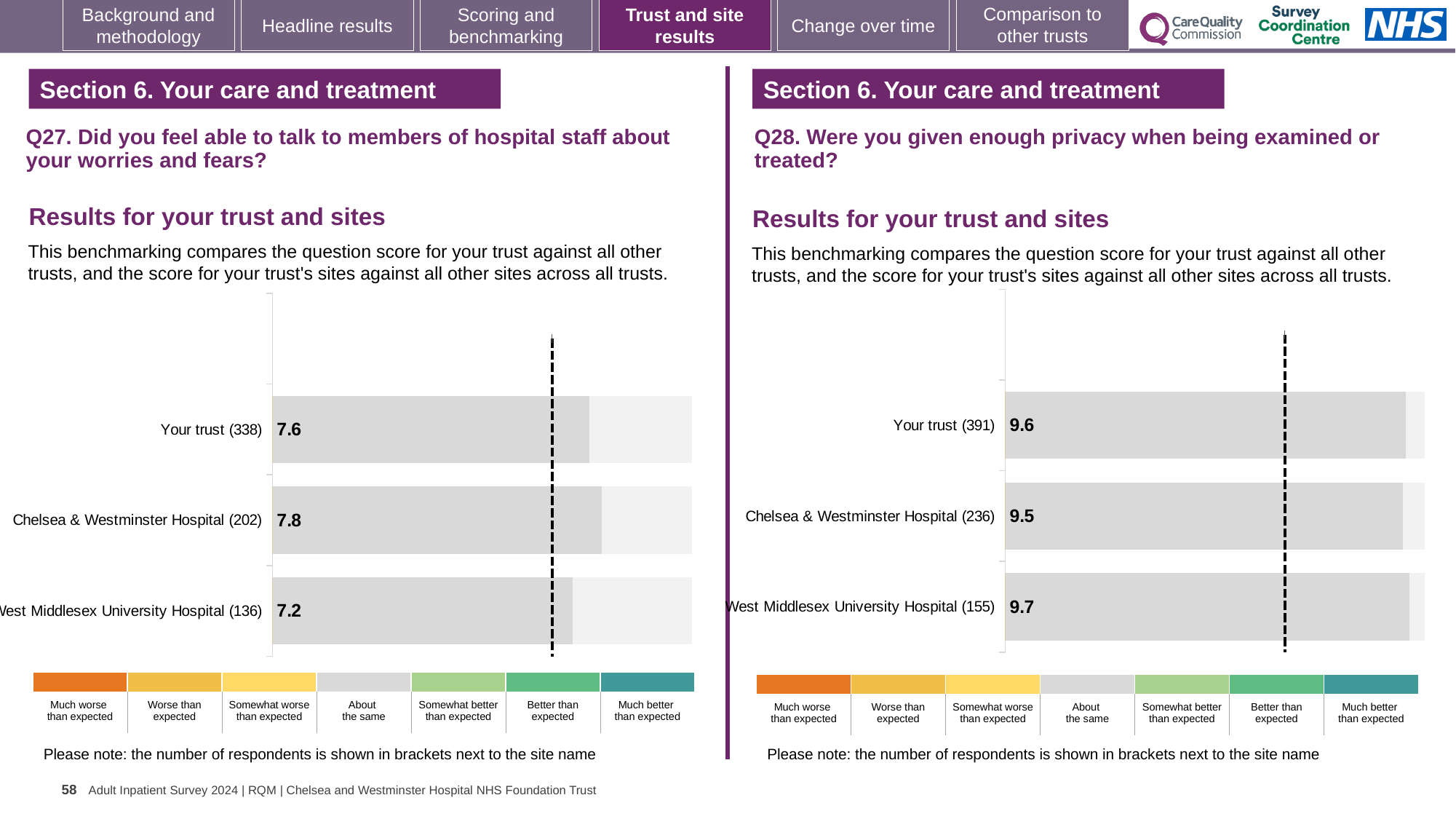
On the Q28 chart (right), which site or trust has the highest score? West Middlesex University Hospital On the Q27 chart (left), which site or trust has the lowest score? West Middlesex University Hospital On the Q27 chart (left), what is the score for West Middlesex University Hospital? 7.2 On the Q27 chart (left), what is the score for Your trust? 7.6 What kind of chart is used on the Q27 chart (left)? Bar chart On the Q27 chart (left), how many respondents are shown in brackets for Your trust? 338 How many bars are plotted on the Q28 chart (right)? 3 On the Q28 chart (right), which is larger, the score for Your trust or the score for Chelsea & Westminster Hospital? Your trust On the Q28 chart (right), what is the score for Chelsea & Westminster Hospital? 9.5 On the Q28 chart (right), what is the score for West Middlesex University Hospital? 9.7 On the Q27 chart (left), which site or trust has the highest score? Chelsea & Westminster Hospital On the Q27 chart (left), what is the difference between the scores for Chelsea & Westminster Hospital and West Middlesex University Hospital? 0.6